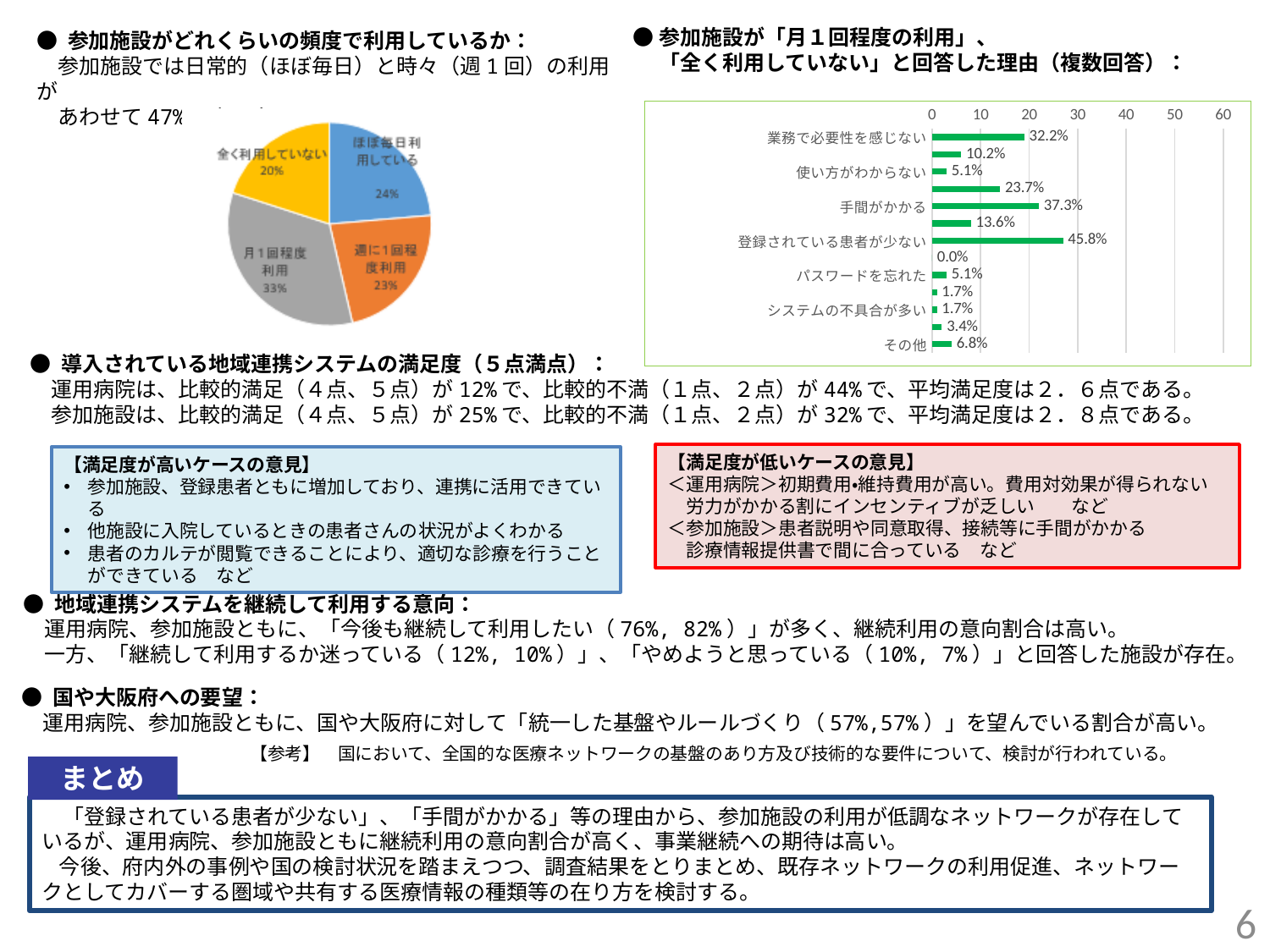
In the pie chart on the left, what percentage answered 「全く利用していない」? 20% What type of chart is the chart on the right? bar chart In the pie chart on the left, how many categories are shown? 4 In the pie chart on the left, which category has the largest share? 月１回程度利用 In the bar chart on the right, which labeled reason has the highest value? 登録されている患者が少ない In the pie chart on the left, what percentage of participating facilities answered 「ほぼ毎日利用している」? 24% In the pie chart on the left, which category has the smallest share? 全く利用していない In the pie chart on the left, what is the combined share of 「ほぼ毎日利用している」 and 「週に１回程度利用」? 47% In the pie chart on the left, what percentage of participating facilities answered 「月１回程度利用」? 33% In the bar chart on the right, what is the difference between 「業務で必要性を感じない」 and 「使い方がわからない」? 27.1% In the bar chart on the right, what is the value for 「手間がかかる」? 37.3% In the bar chart on the right, what is the value for 「登録されている患者が少ない」? 45.8%